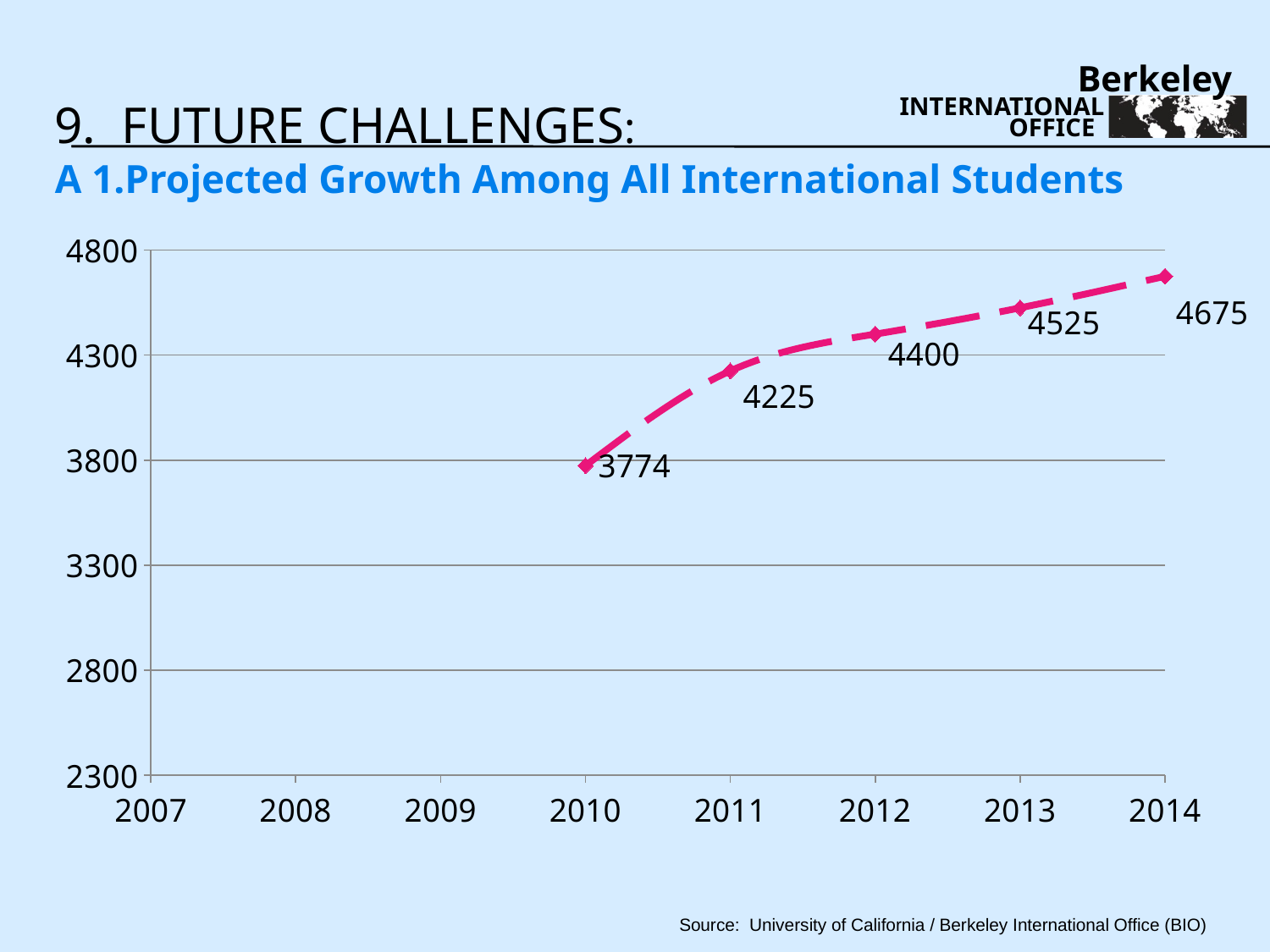
What is the difference between the values for 2011 and 2010? 451 Which is larger, the value for 2013 or the value for 2011? 2013 What is the projected number of international students in 2014? 4675 Is the value for 2012 greater or less than 4300? greater What kind of chart is shown on the slide? line chart What is the projected number of international students in 2012? 4400 Which year has the lowest plotted value? 2010 Which year has the highest projected number of international students? 2014 What is the projected number of international students in 2010? 3774 What is the difference between the values for 2014 and 2013? 150 Do the values rise or fall from 2010 to 2014? rise How many data points are plotted on the line? 5